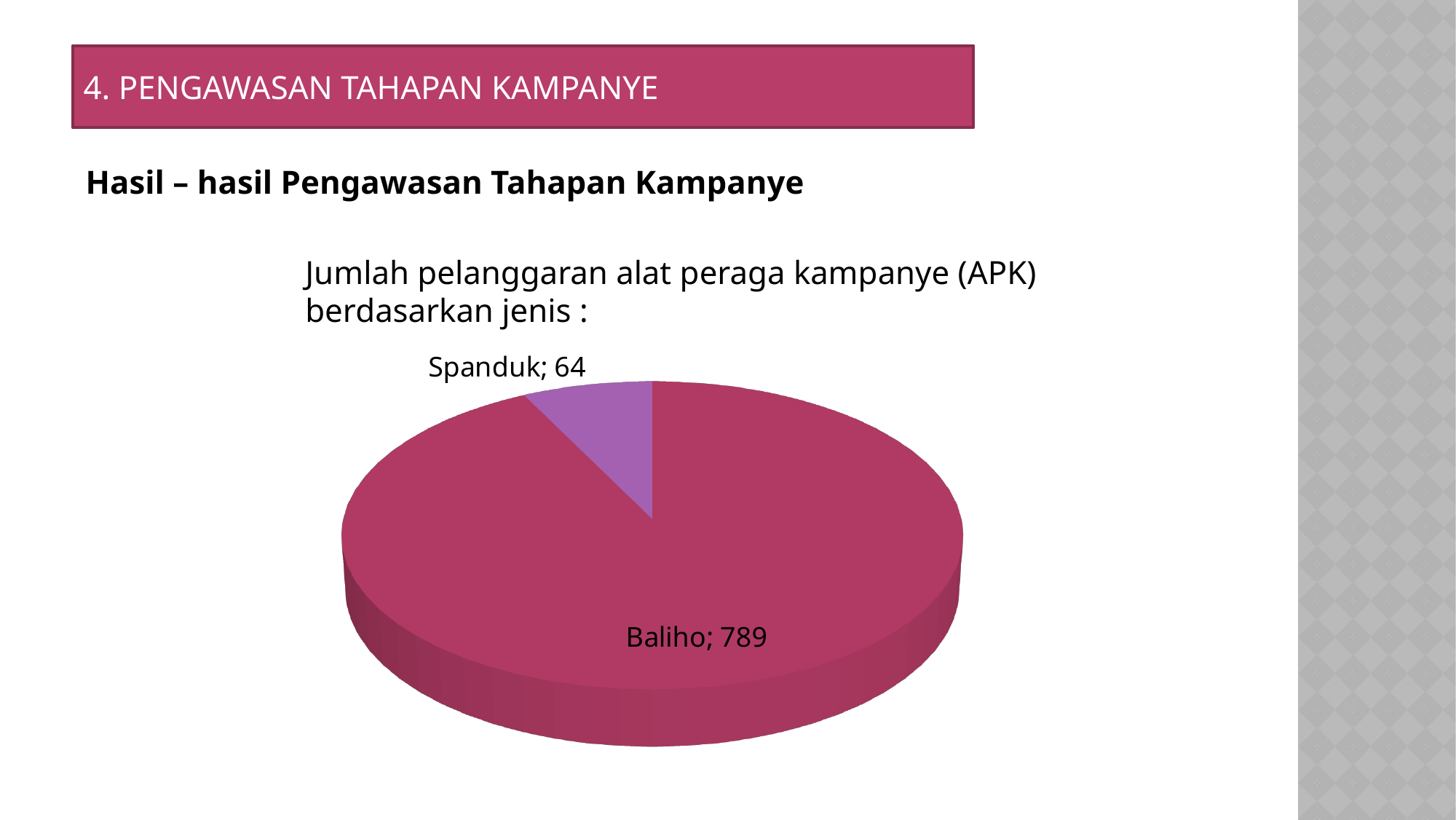
Which is larger, the value for Baliho or the value for Spanduk? Baliho Which category has the largest slice in the pie chart? Baliho What is the total of all slices in the pie chart? 853 What is the title of the pie chart? Jumlah pelanggaran alat peraga kampanye (APK) berdasarkan jenis : What is the value for Baliho in the pie chart? 789 Which category has the smallest slice in the pie chart? Spanduk What share of the pie does Spanduk represent? 7.5% What is the difference between the Baliho and Spanduk values? 725 What kind of chart is shown on the slide? Pie chart How many categories are shown in the pie chart? 2 What is the value for Spanduk in the pie chart? 64 What colour is the Spanduk slice in the pie chart? Purple